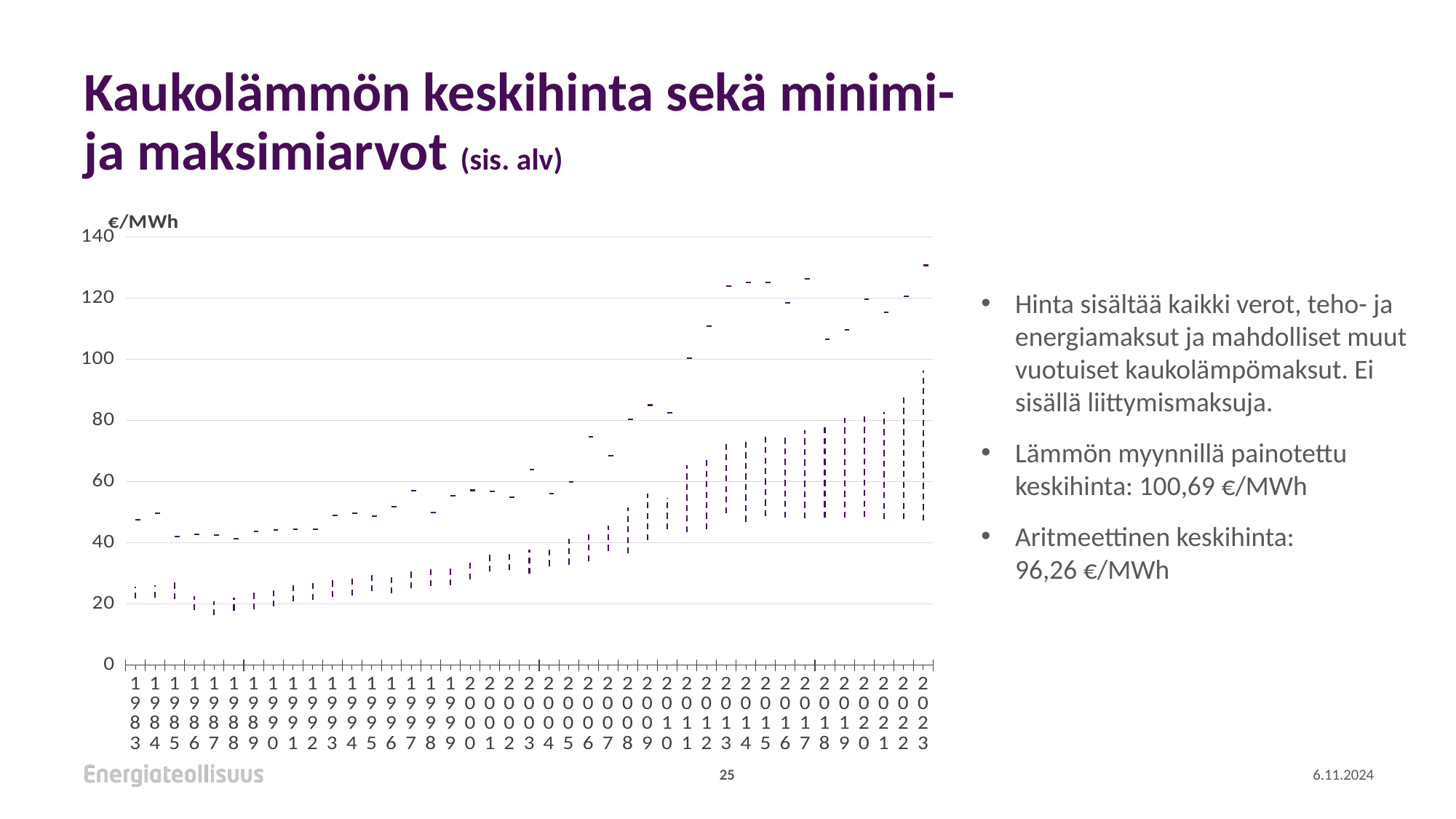
What is the first year shown on the x axis of the chart? 1983 Do the maximum values generally rise or fall from 1983 to 2023? rise What unit is shown on the vertical axis of the chart? €/MWh Is the minimum value for 1983 greater or less than 40? less What is the last year shown on the x axis of the chart? 2023 What is the title of the chart on the slide? Kaukolämmön keskihinta sekä minimi- ja maksimiarvot (sis. alv) How many years are shown along the x axis of the chart? 41 Is the maximum value for 1990 greater or less than 60? less Is the maximum value for 2010 greater or less than 80? greater What is the highest tick value shown on the vertical axis of the chart? 140